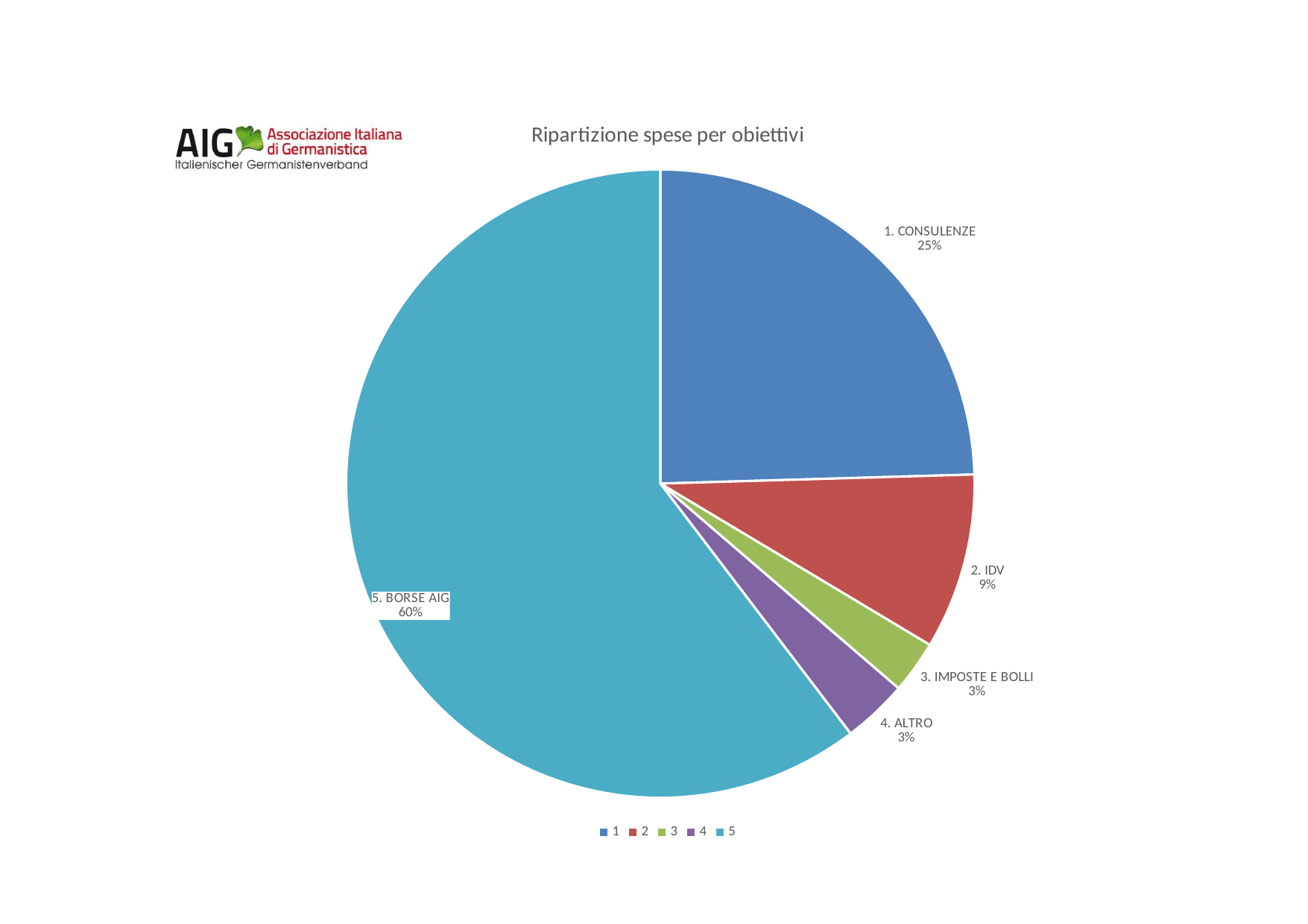
Which is larger, the share for 2. IDV or the share for 4. ALTRO? 2. IDV What is the value shown for 3. IMPOSTE E BOLLI? 3% What share of the pie does 5. BORSE AIG take? 60% What share of the pie does 1. CONSULENZE take? 25% What is the combined share of 1. CONSULENZE and 2. IDV? 34% Which category has the largest slice of the pie? 5. BORSE AIG What is the difference between the shares of 5. BORSE AIG and 1. CONSULENZE? 35% How many slices does the pie chart have? 5 What kind of chart is shown on the slide? pie chart What is the value shown for 2. IDV? 9% What is the title of the chart? Ripartizione spese per obiettivi How many entries does the legend list? 5